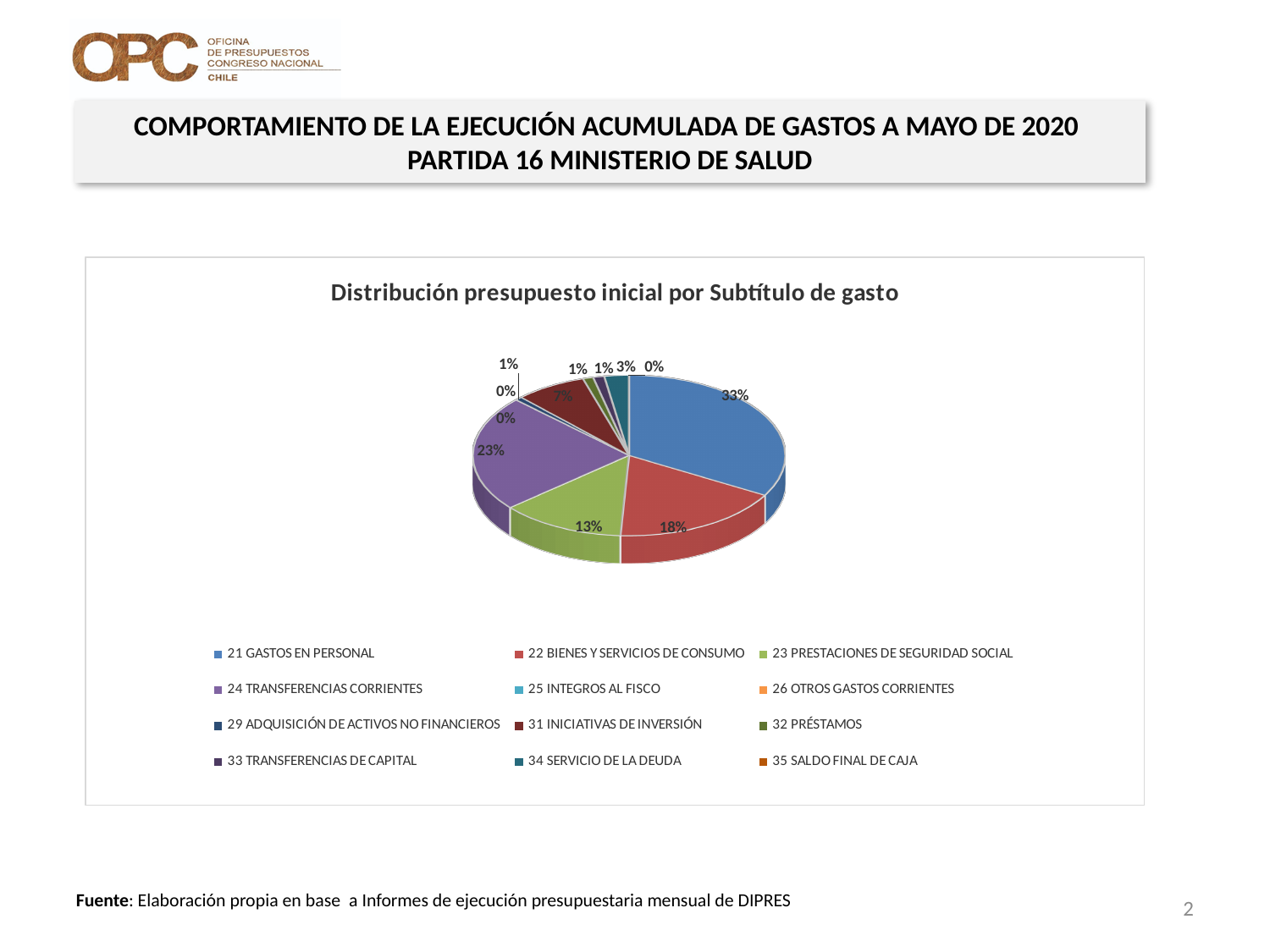
How many categories does the legend of the pie chart list? 12 What kind of chart is shown on the slide? pie chart What share of the pie does 21 GASTOS EN PERSONAL have? 33% What is the difference in percentage points between the shares of 21 GASTOS EN PERSONAL and 24 TRANSFERENCIAS CORRIENTES? 10 percentage points What share of the pie does 31 INICIATIVAS DE INVERSIÓN have? 7% What share of the pie does 24 TRANSFERENCIAS CORRIENTES have? 23% Which has the larger share, 22 BIENES Y SERVICIOS DE CONSUMO or 23 PRESTACIONES DE SEGURIDAD SOCIAL? 22 BIENES Y SERVICIOS DE CONSUMO What is the title of the chart? Distribución presupuesto inicial por Subtítulo de gasto Which has the larger share, 24 TRANSFERENCIAS CORRIENTES or 31 INICIATIVAS DE INVERSIÓN? 24 TRANSFERENCIAS CORRIENTES Which category has the largest share of the pie? 21 GASTOS EN PERSONAL